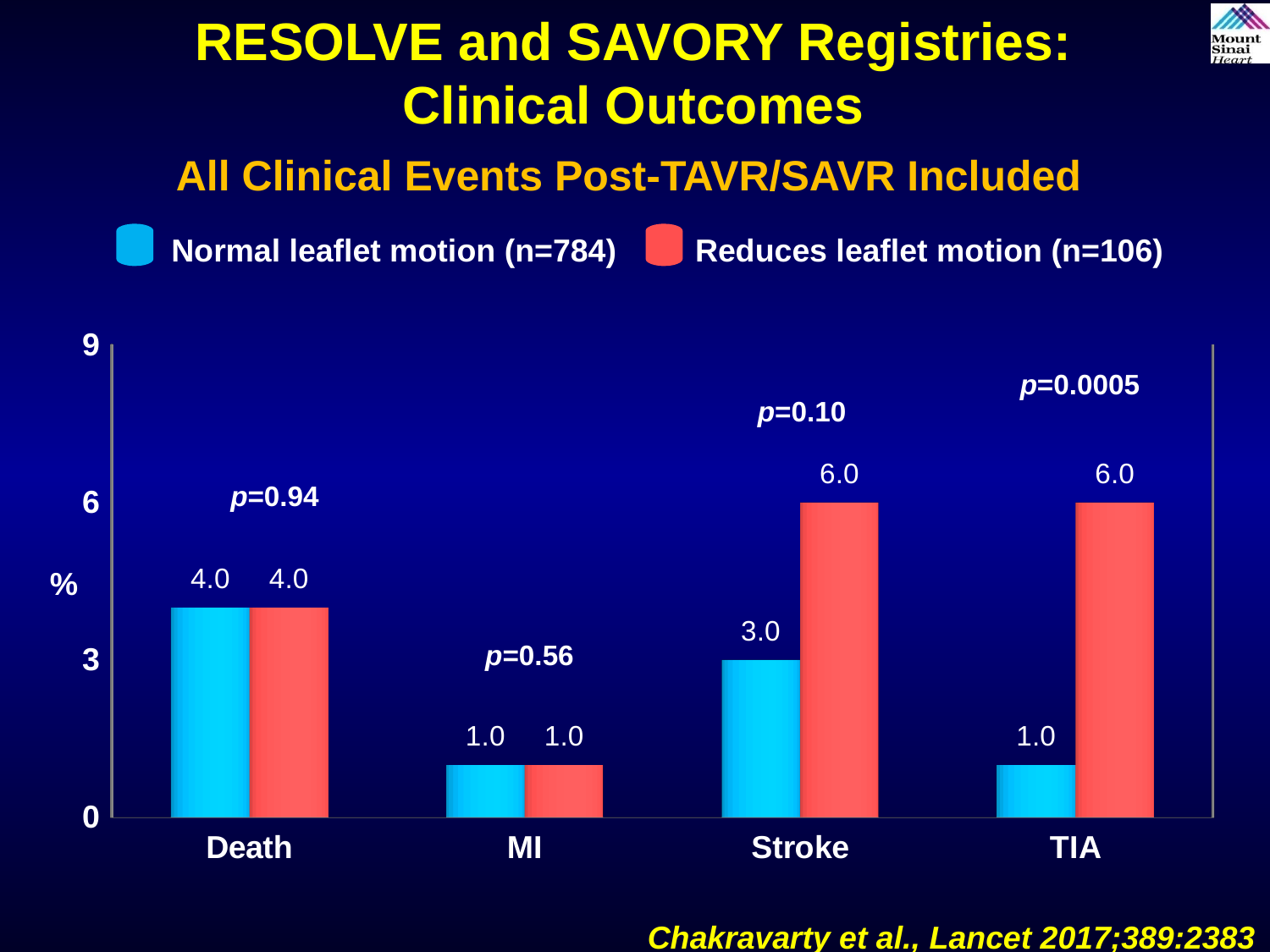
What kind of chart is shown on the slide? Bar chart What is the value for Stroke in the Reduces leaflet motion series? 6.0 What is the value for Death in the Normal leaflet motion series? 4.0 For Stroke, which series has the larger value, Normal leaflet motion or Reduces leaflet motion? Reduces leaflet motion What is the value for MI in the Reduces leaflet motion series? 1.0 How many categories are shown on the x axis? 4 How many series does the legend list? 2 What is the difference between the Reduces leaflet motion and Normal leaflet motion values for TIA? 5.0 Which category has the lowest value in the Reduces leaflet motion series? MI What is the value for TIA in the Normal leaflet motion series? 1.0 What p-value is shown above the TIA bars? p=0.0005 Which category has the highest value in the Normal leaflet motion series? Death